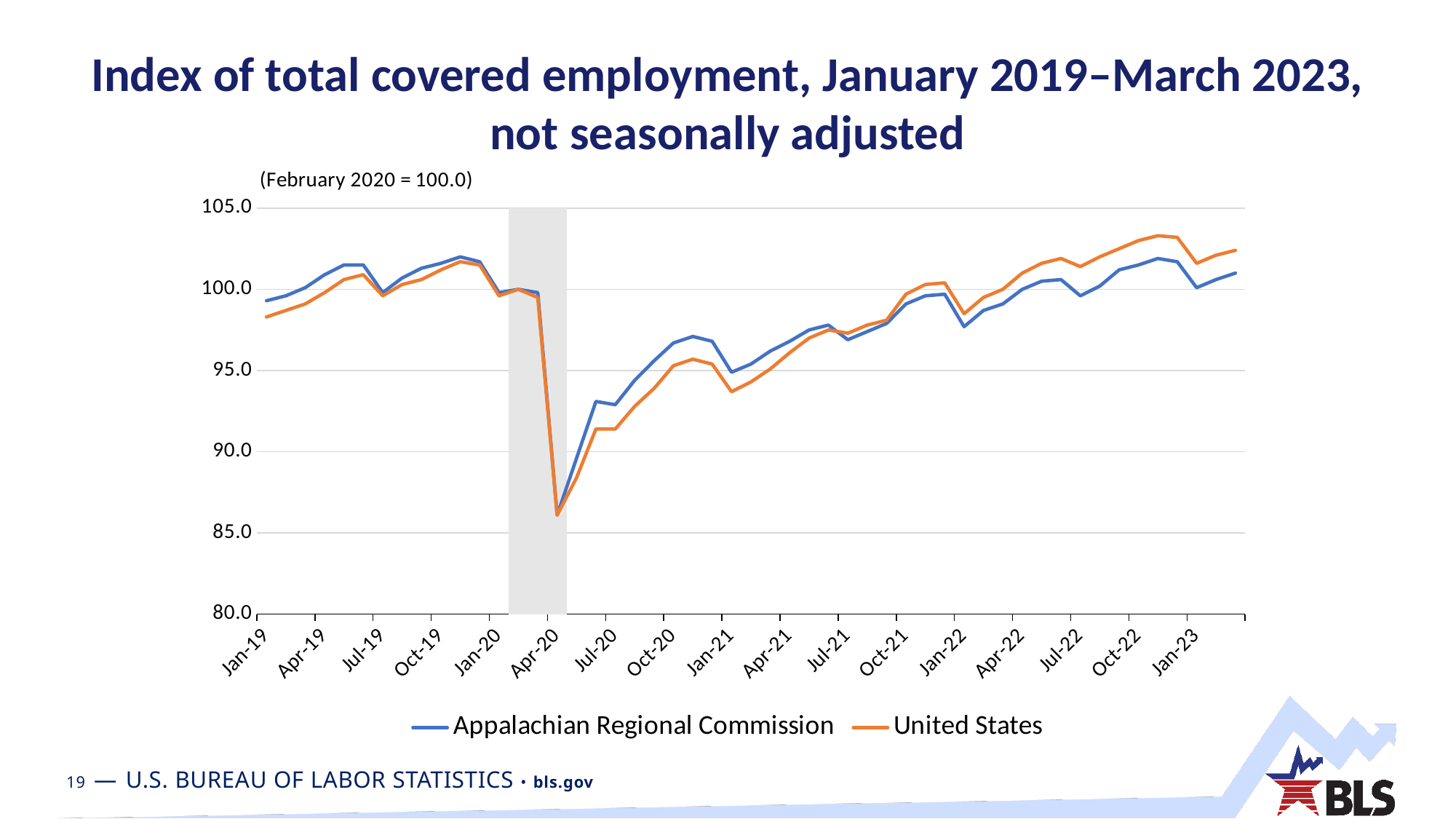
Is the value for the Appalachian Regional Commission in Apr-20 greater or less than 90.0? less Is the value for the United States in Jan-21 greater or less than 95.0? less Is the value for the United States in Oct-22 greater or less than 100.0? greater What is the base period of the index, according to the note above the chart? February 2020 = 100.0 In Jan-21, which series has the higher value, Appalachian Regional Commission or United States? Appalachian Regional Commission In which month does the United States series reach its lowest value? Apr-20 What is the index value for both series in February 2020? 100.0 How many series does the legend list? 2 What kind of chart is shown on the slide? line chart Which two series are plotted in the chart? Appalachian Regional Commission and United States In Oct-22, which series has the higher value, Appalachian Regional Commission or United States? United States Between Apr-20 and Oct-22, does the United States series generally rise or fall? rise